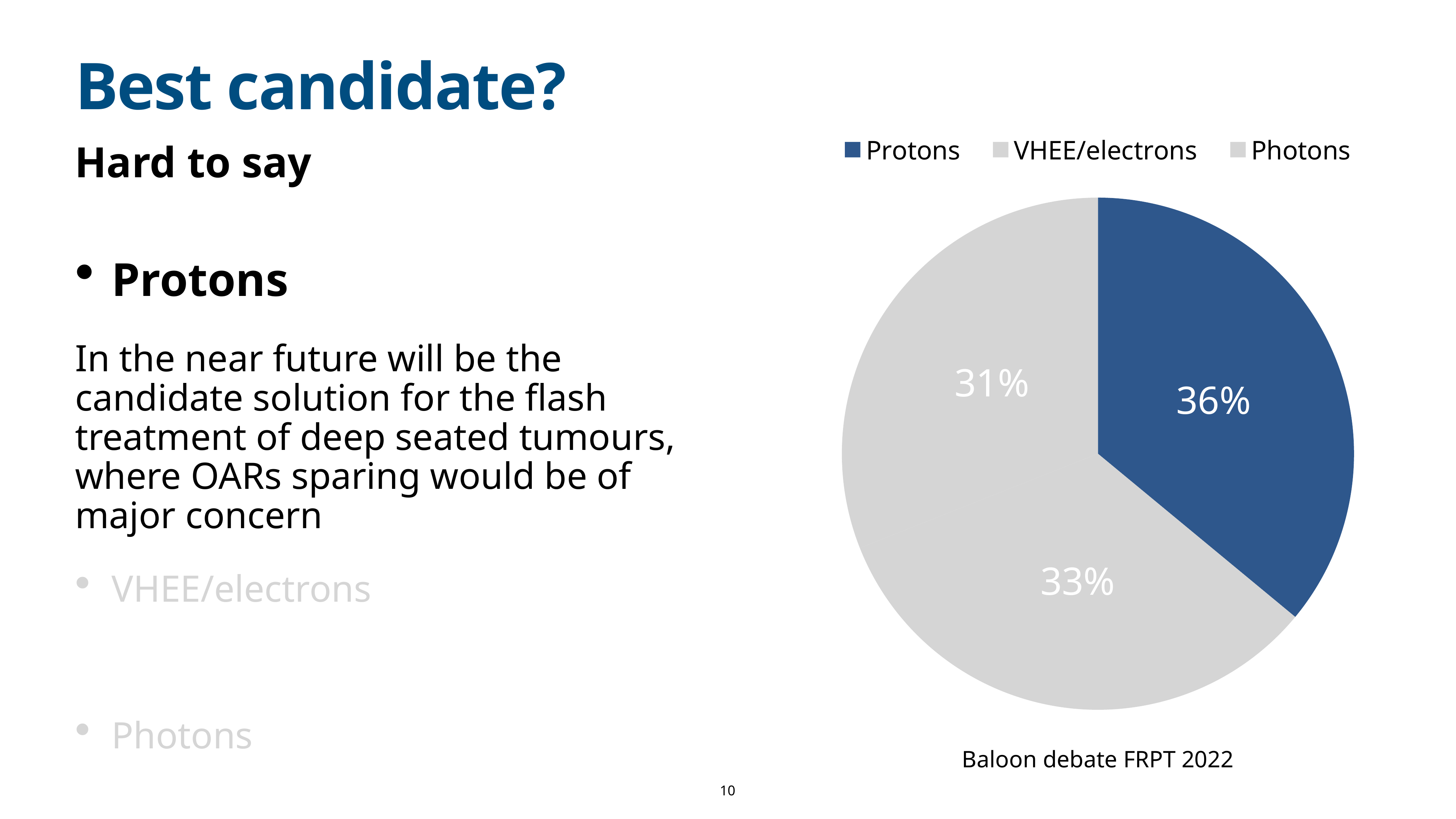
What percentage of the pie chart is the Protons slice? 36% What is the difference between the Protons slice and the 33% slice in the pie chart? 3% What is the difference between the largest slice (36%) and the smallest slice (31%) in the pie chart? 5% What type of chart is shown on the slide? pie chart What source text is shown below the pie chart? Baloon debate FRPT 2022 What colour is the Protons slice in the pie chart? blue How many entries does the pie chart legend list? 3 How many slices does the pie chart have? 3 Which category has the largest slice in the pie chart? Protons What is the smallest percentage shown on the pie chart? 31% Is the Protons slice larger or smaller than the 33% slice? larger Is the Protons share of the pie chart greater or less than 30%? greater